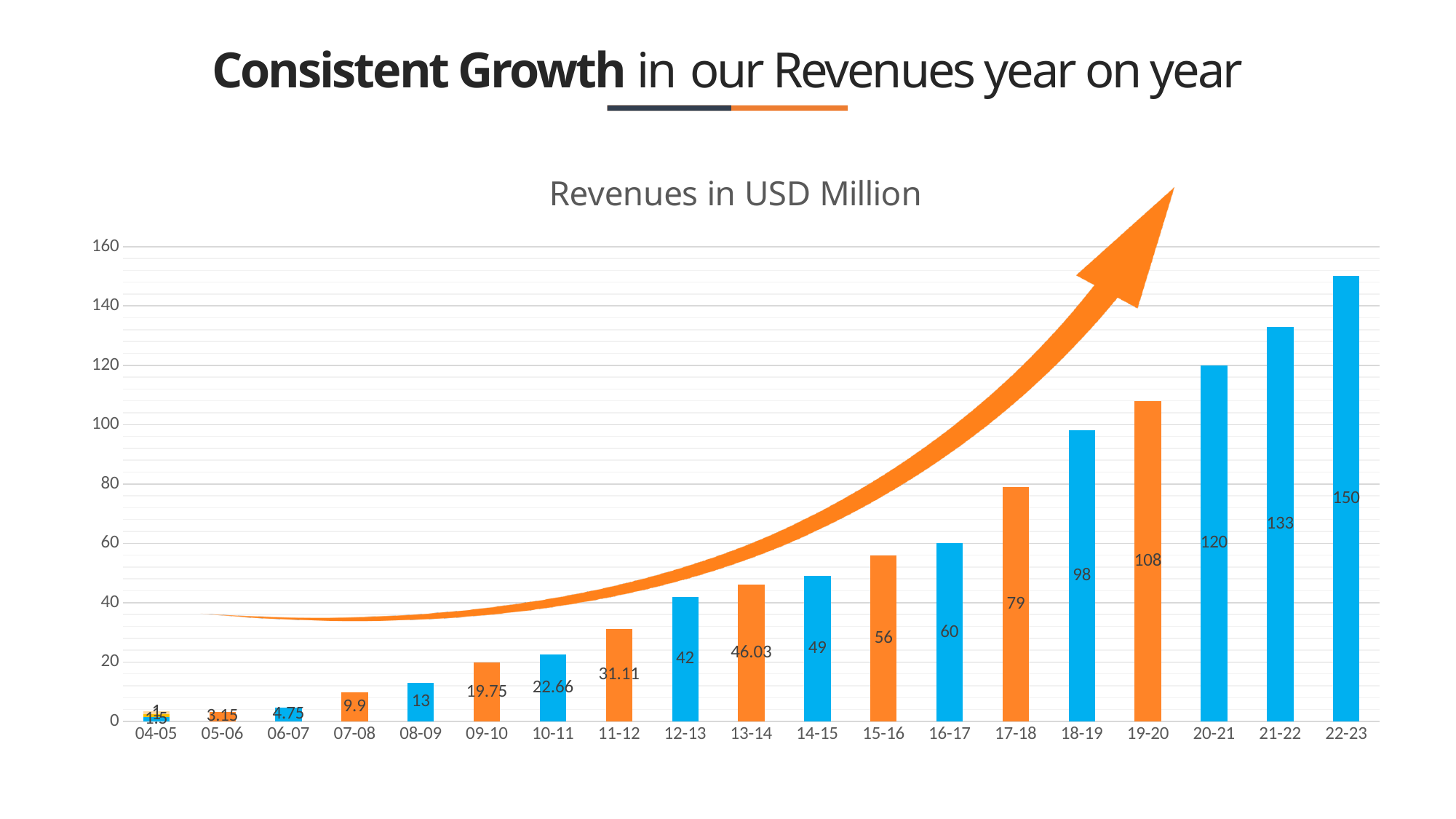
What is the revenue value shown for 22-23? 150 What is the difference between the revenue for 22-23 and the revenue for 21-22? 17 What is the revenue value shown for 10-11? 22.66 How many years are shown on the x axis? 19 What is the title of the chart? Revenues in USD Million What is the revenue value shown for 17-18? 79 Which is larger, the revenue for 15-16 or the revenue for 14-15? 15-16 Which year has the highest revenue? 22-23 What is the revenue value shown for 13-14? 46.03 What is the difference between the revenue for 19-20 and the revenue for 18-19? 10 Is the revenue for 20-21 greater or less than 100? greater What kind of chart is shown on the slide? Bar chart